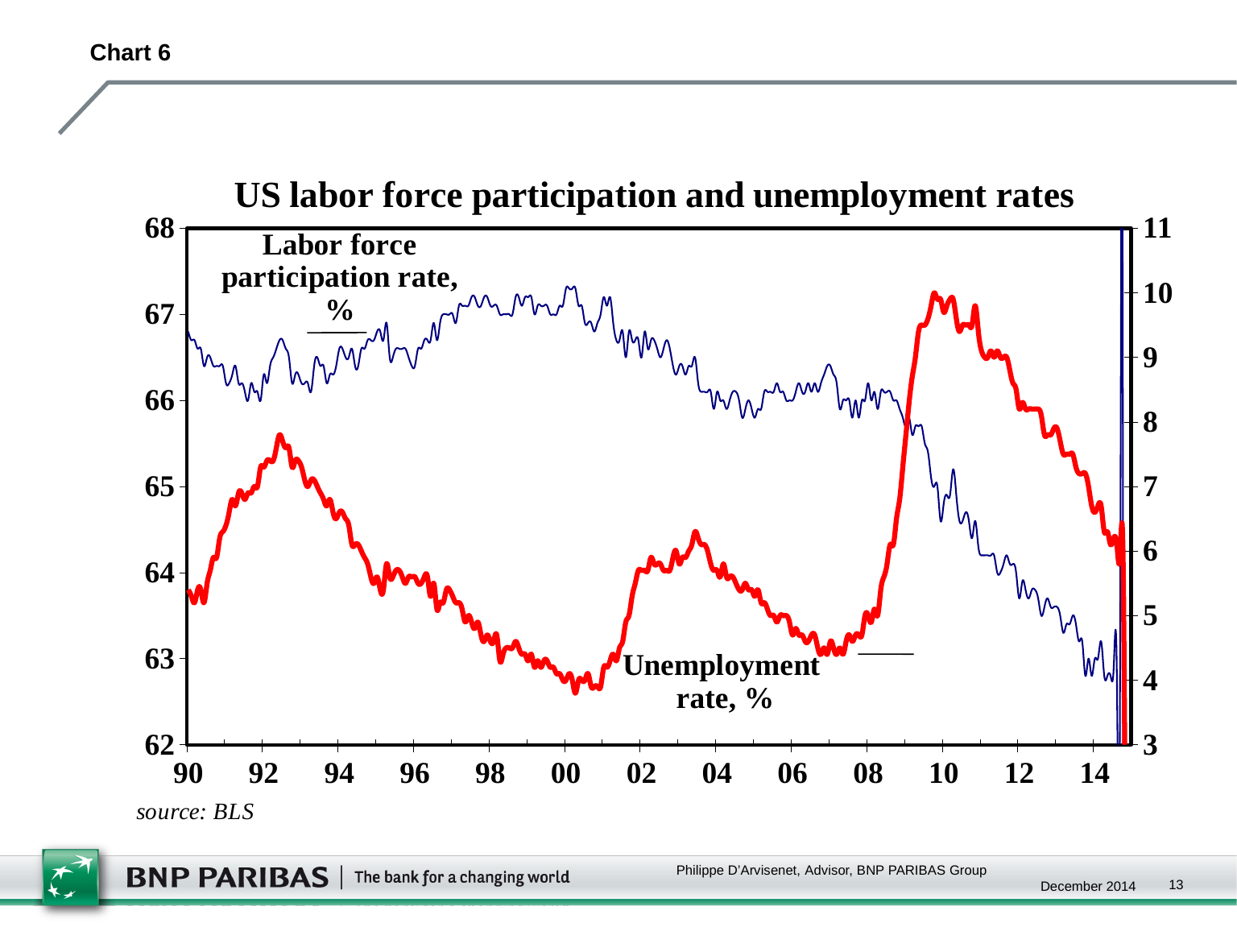
How many series are plotted on the chart? 2 Does the unemployment rate rise or fall between 2007 and 2009? rise How many year labels are shown on the x axis? 13 Does the labor force participation rate rise or fall between 2008 and 2014? fall What is the source cited below the chart? BLS Is the labor force participation rate at the end of 2014 greater or less than 64? less What kind of chart is shown on the slide? line chart Does the unemployment rate rise or fall between 2010 and 2014? fall Is the unemployment rate around 2010 greater or less than 9? greater Is the unemployment rate around 2000 greater or less than 5? less What is the title of the chart? US labor force participation and unemployment rates